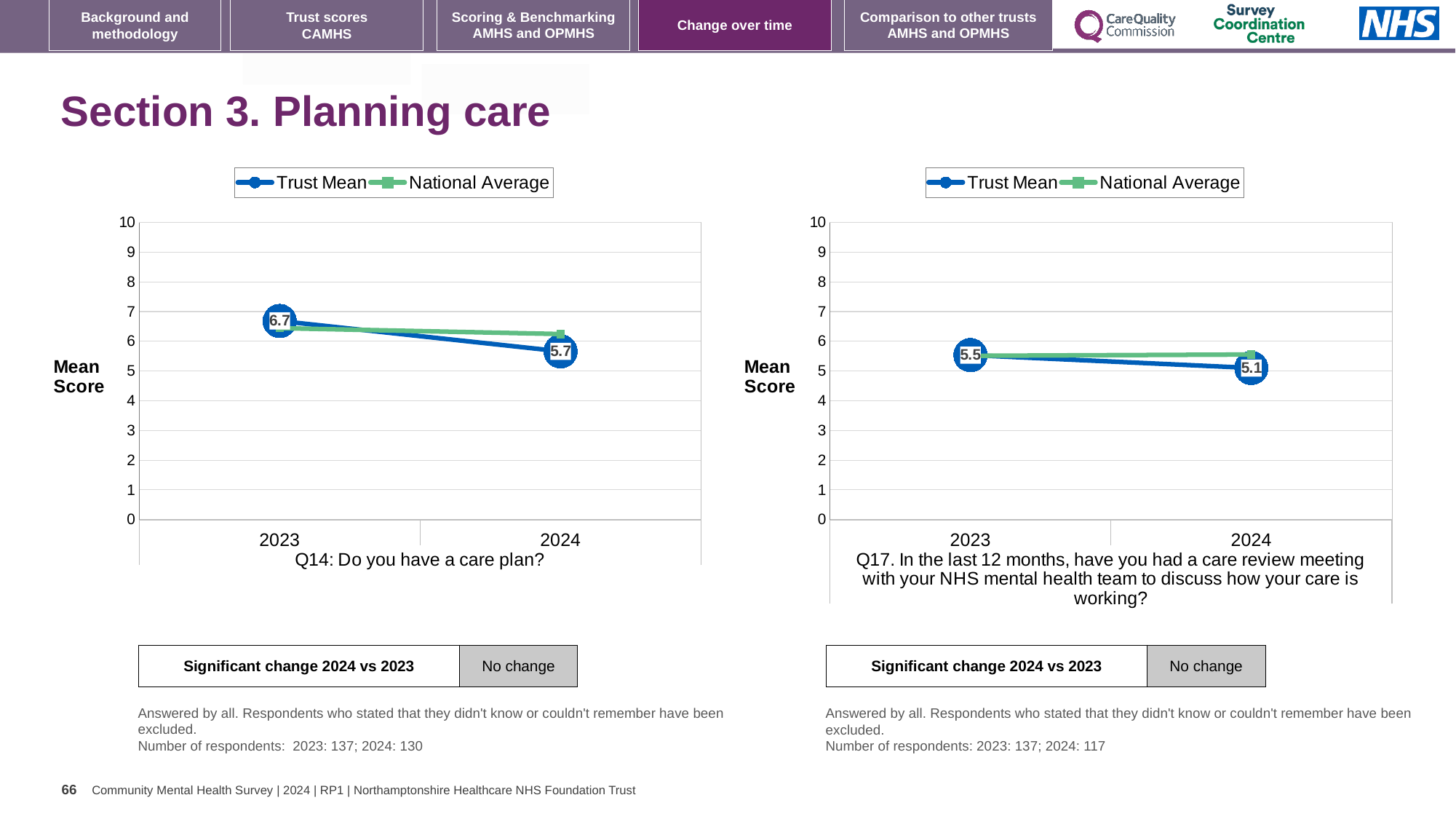
In the Q14 chart (left), is the National Average value for 2023 greater or less than 6? greater In the Q17 chart (right), what is the Trust Mean score for 2024? 5.1 In the Q14 chart (left), what is the Trust Mean score for 2024? 5.7 In the Q14 chart (left), does the Trust Mean rise or fall from 2023 to 2024? fall In the Q14 chart (left), what is the Trust Mean score for 2023? 6.7 How many series does the legend of the Q17 chart (right) list? 2 How many years are shown on the x axis of the Q17 chart (right)? 2 In the Q14 chart (left), by how much did the Trust Mean score fall from 2023 to 2024? 1.0 In the Q17 chart (right), what is the difference between the Trust Mean scores for 2023 and 2024? 0.4 In the Q17 chart (right), what is the Trust Mean score for 2023? 5.5 What type of chart is the Q14 chart (left)? line chart In the Q14 chart (left), which year has the higher Trust Mean score, 2023 or 2024? 2023